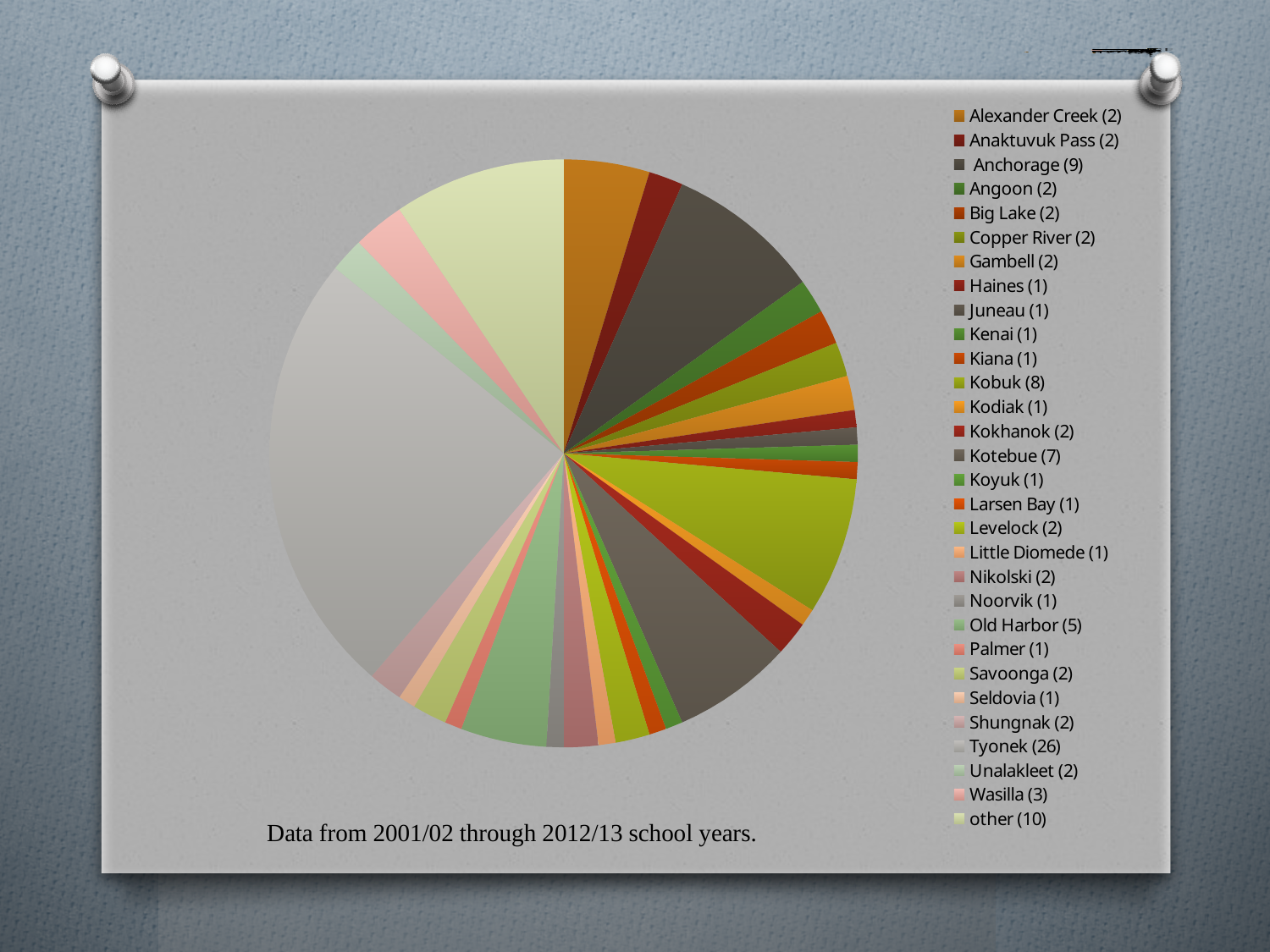
According to the legend, what is the value for Old Harbor? 5 What school years does the caption say the data covers? 2001/02 through 2012/13 According to the legend, what is the value for Tyonek? 26 How many categories are listed in the legend? 30 Which category has the largest slice of the pie? Tyonek What type of chart is shown on the slide? pie chart What is the difference between the value for Tyonek and the value for other? 16 According to the legend, what is the value for Anchorage? 9 What is the difference between the value for Tyonek and the value for Anchorage? 17 According to the legend, what is the value for Kotebue? 7 According to the legend, what is the value for Kobuk? 8 Which is larger, the value for Anchorage or the value for Kobuk? Anchorage